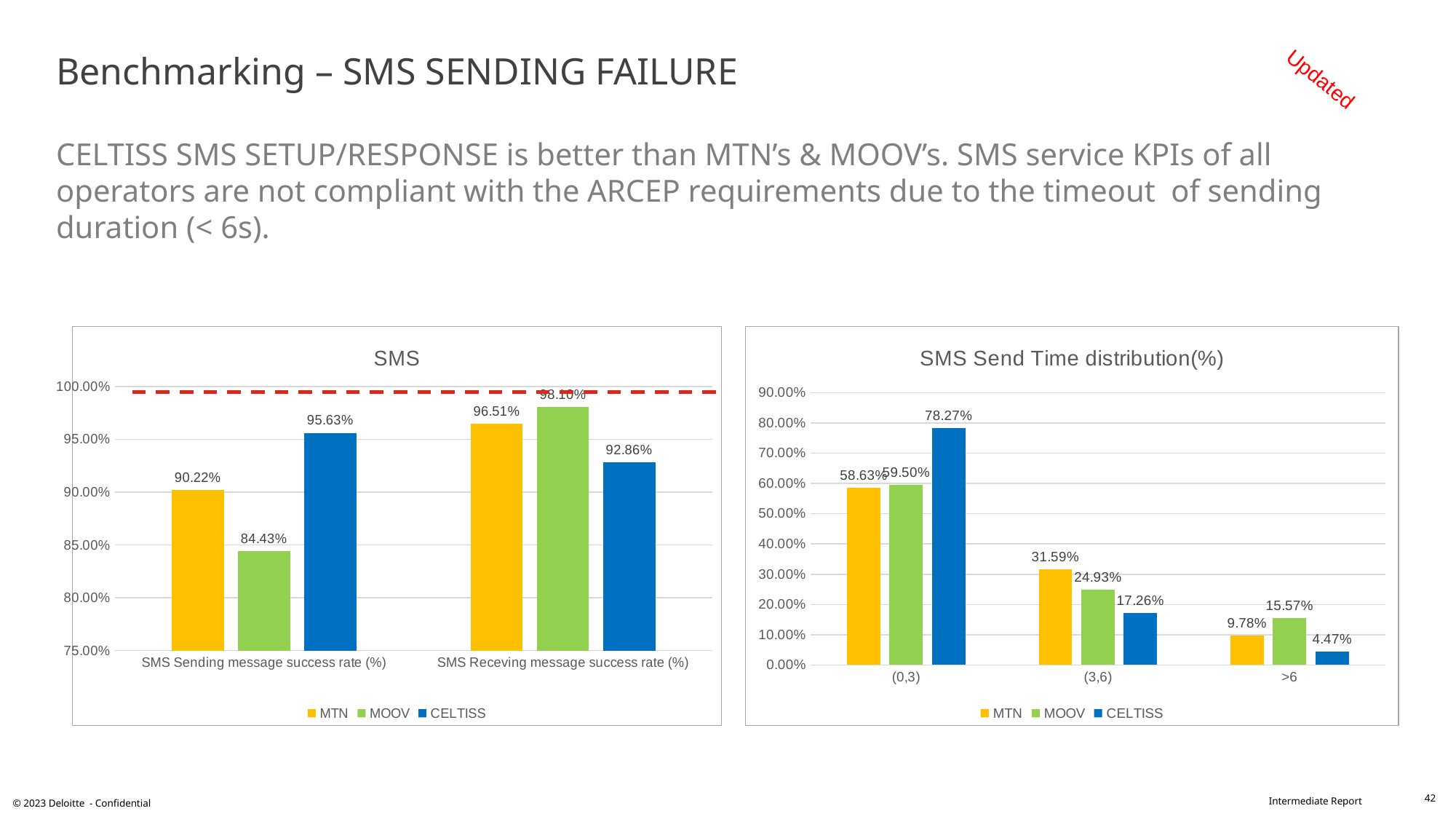
In the "SMS Send Time distribution(%)" chart, what is the difference between MTN's and CELTISS's values in the >6 category? 5.31% In the "SMS" chart, what is the SMS Sending message success rate for MOOV? 84.43% What kind of chart is the "SMS Send Time distribution(%)" chart? Bar chart In the "SMS" chart, which operator has the lowest SMS Receving message success rate? CELTISS In the "SMS Send Time distribution(%)" chart, what is the value for CELTISS in the (0,3) category? 78.27% In the "SMS" chart, how many series does the legend list? 3 In the "SMS" chart, what is the SMS Sending message success rate for CELTISS? 95.63% In the "SMS Send Time distribution(%)" chart, which operator has the highest value in the (3,6) category? MTN In the "SMS Send Time distribution(%)" chart, how many categories are shown on the x axis? 3 In the "SMS" chart, what is the difference between CELTISS's and MTN's SMS Sending message success rate? 5.41% In the "SMS" chart, which operator has the lowest SMS Sending message success rate? MOOV In the "SMS Send Time distribution(%)" chart, what is the value for MOOV in the >6 category? 15.57%